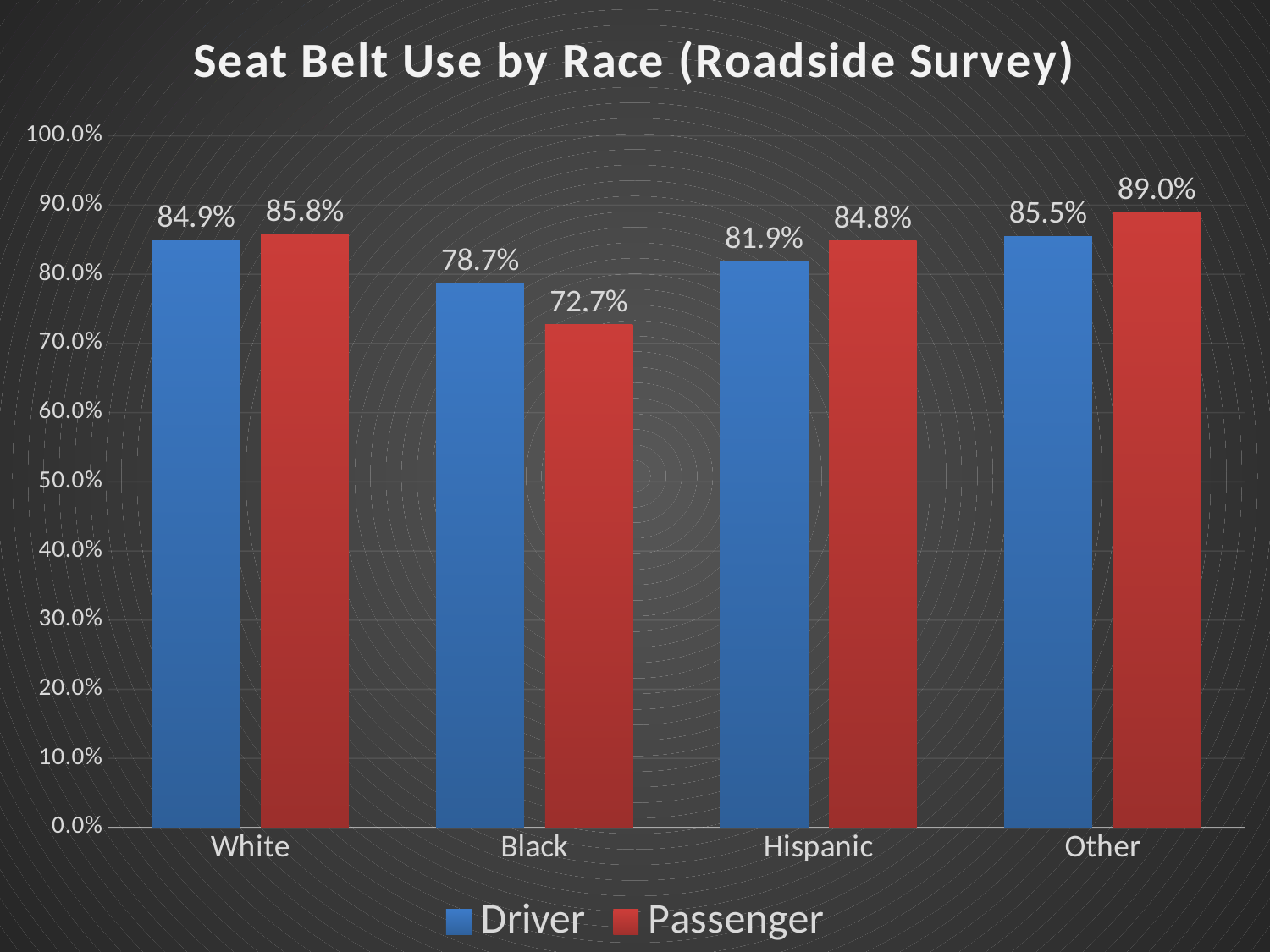
What is the Passenger seat belt use value for Black? 72.7% What kind of chart is shown on the slide? Bar chart What is the Driver seat belt use value for White? 84.9% What is the difference between the Driver and Passenger values for Black? 6.0% What is the title of the chart? Seat Belt Use by Race (Roadside Survey) What is the Passenger value for Other? 89.0% How many race categories are shown on the x axis? 4 Is the Driver value for Black greater or less than 80.0%? less Which is larger for Hispanic: the Driver value or the Passenger value? Passenger Which race category has the highest Passenger value? Other How many series does the legend list? 2 Which race category has the lowest Driver value? Black